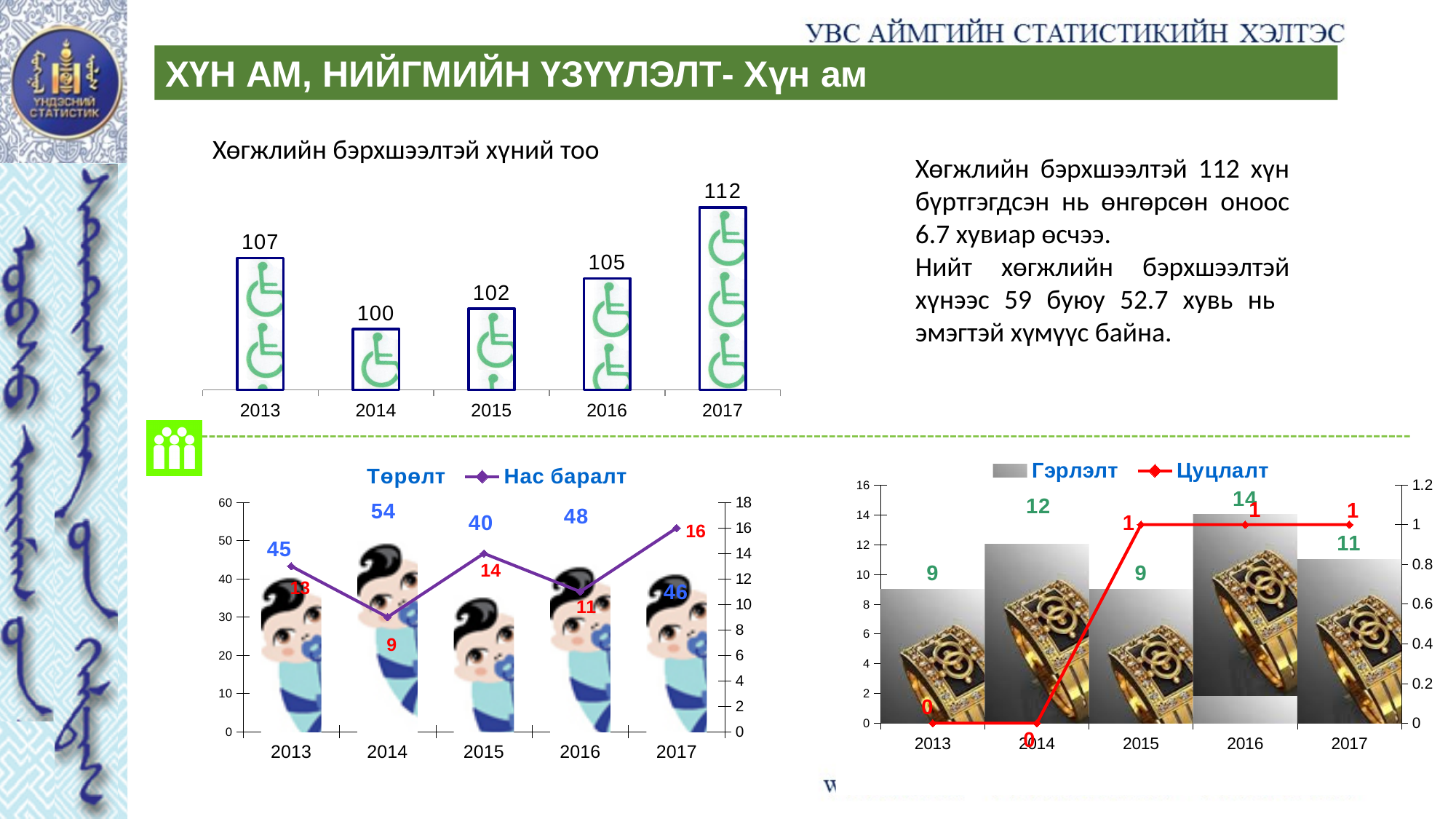
In the chart 'Хөгжлийн бэрхшээлтэй хүний тоо', how many years are shown on the x axis? 5 In the chart 'Хөгжлийн бэрхшээлтэй хүний тоо', which year has the lowest value? 2014 In the bottom-left chart (Төрөлт / Нас баралт), what is the Нас баралт value for 2017? 16 In the bottom-left chart (Төрөлт / Нас баралт), how many series does the legend list? 2 In the chart 'Хөгжлийн бэрхшээлтэй хүний тоо', what is the difference between the 2017 and 2013 values? 5 In the bottom-right chart (Гэрлэлт / Цуцлалт), what is the Цуцлалт value for 2014? 0 In the chart 'Хөгжлийн бэрхшээлтэй хүний тоо', what is the value for 2017? 112 In the bottom-right chart (Гэрлэлт / Цуцлалт), what colour is the Цуцлалт line? red In the bottom-left chart (Төрөлт / Нас баралт), which year has the lowest Нас баралт value? 2014 In the bottom-left chart (Төрөлт / Нас баралт), what is the Төрөлт value for 2014? 54 In the bottom-right chart (Гэрлэлт / Цуцлалт), is the Гэрлэлт value for 2014 larger or smaller than the value for 2017? larger In the bottom-right chart (Гэрлэлт / Цуцлалт), what is the Гэрлэлт value for 2016? 14